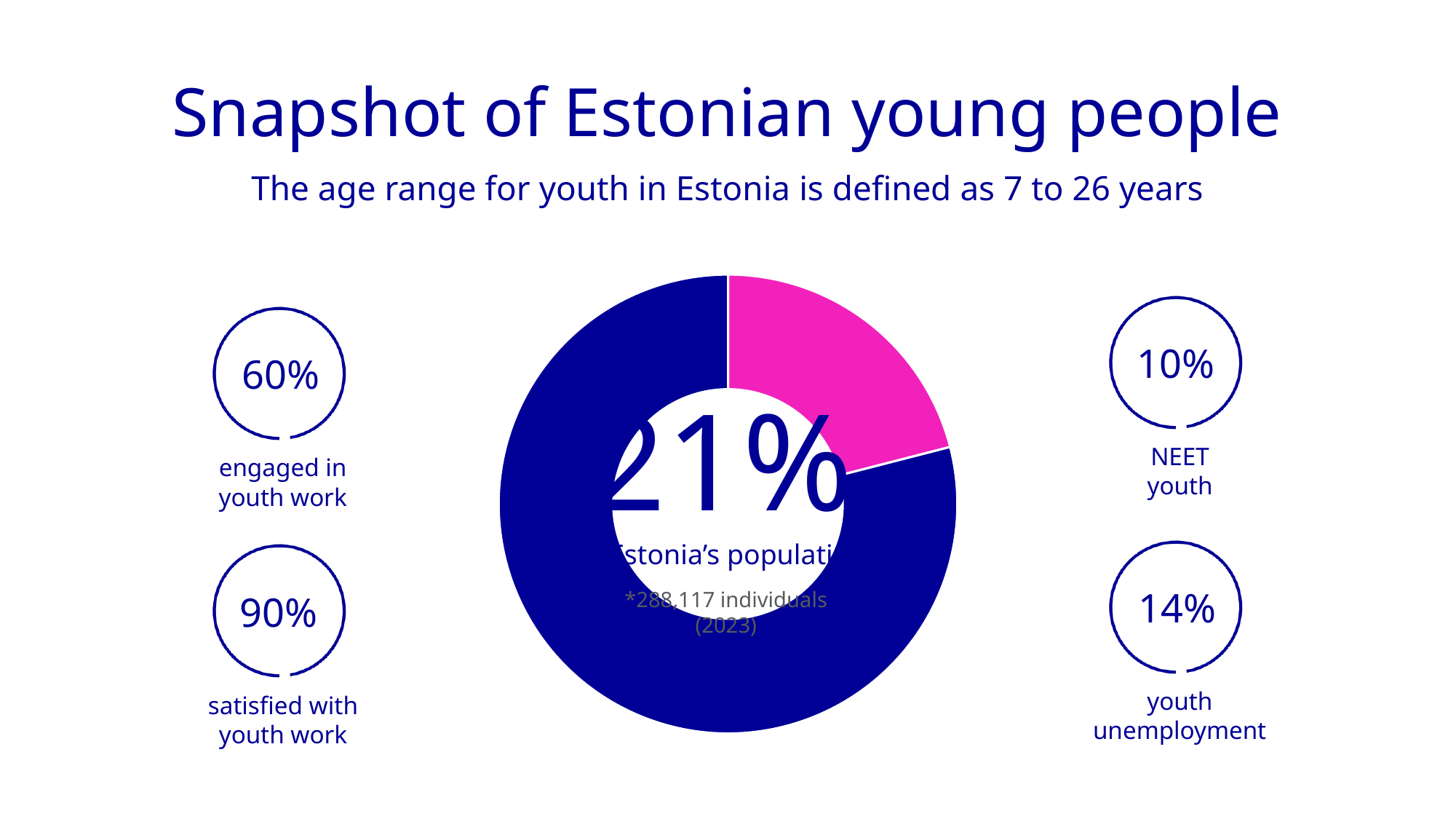
What is the difference between the 'satisfied with youth work' percentage and the 'engaged in youth work' percentage? 30% What percentage of Estonia's population does the pink slice of the donut chart represent? 21% What kind of chart is shown in the centre of the slide? Pie chart (donut) What percentage is shown in the circle labelled 'youth unemployment'? 14% Is the dark blue slice of the donut chart greater or less than half of the whole? greater What percentage is shown in the circle labelled 'NEET youth'? 10% How many slices does the donut chart have? 2 What colour is the slice of the donut chart that represents young people (21%)? Pink Which of the four circled statistics on the slide shows the highest percentage? satisfied with youth work (90%) Which slice of the donut chart is larger, the pink one or the dark blue one? Dark blue What year is given for the population figure in the centre of the donut chart? 2023 How many individuals does the 21% in the donut chart correspond to, according to the note in the centre? 288,117